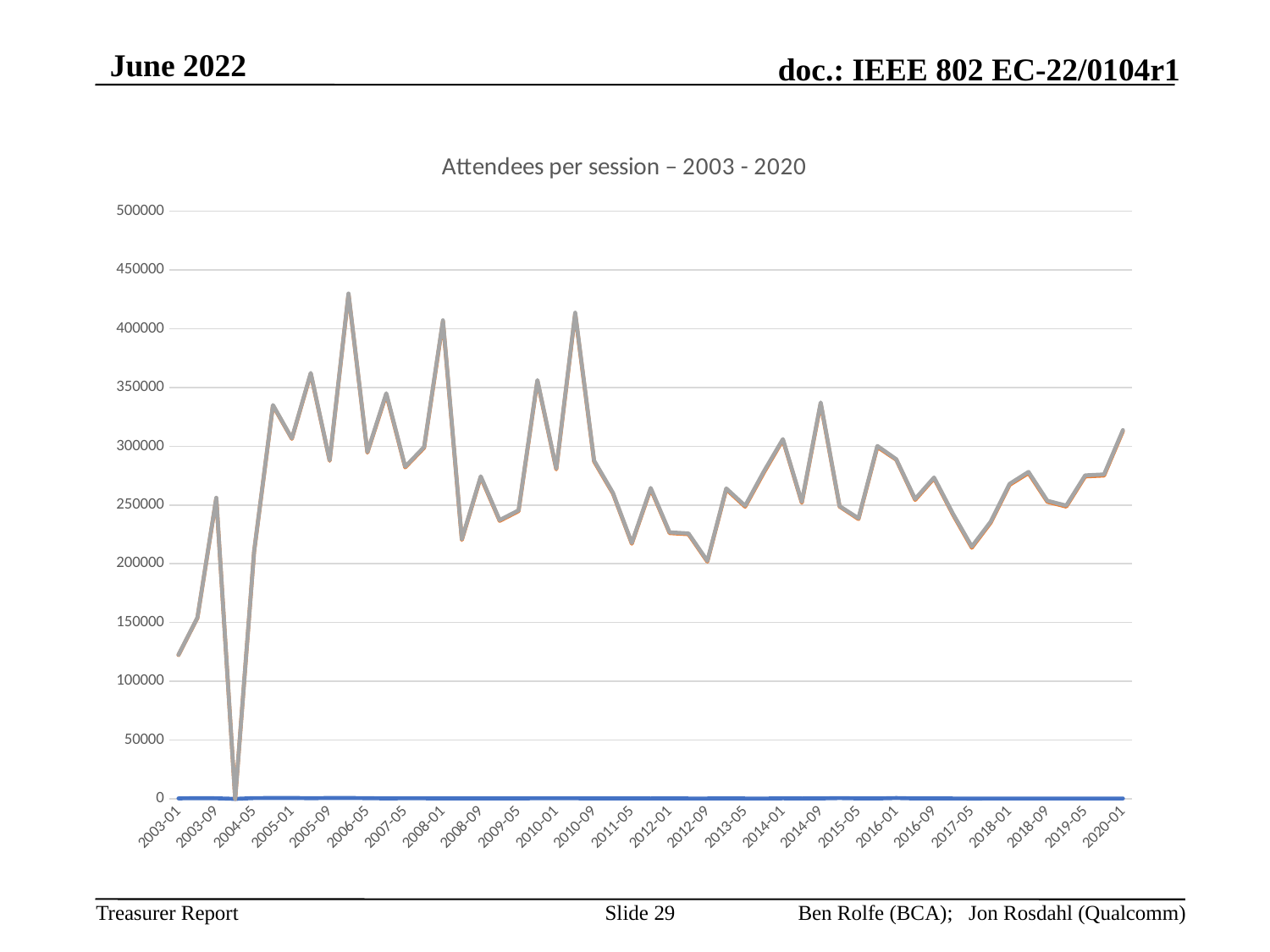
Is the value for 2003-01 greater or less than 100000? greater Is the blue line that runs along the bottom of the chart greater or less than 50000? less Which is larger, the value for 2003-01 or the value for 2003-09? 2003-09 Is the highest peak of the attendee line greater or less than 400000? greater What is the title of the chart? Attendees per session – 2003 - 2020 What kind of chart is shown on the slide? line chart Does the attendee line rise or fall between 2003-01 and 2003-09? rise What is the highest value shown on the vertical axis? 500000